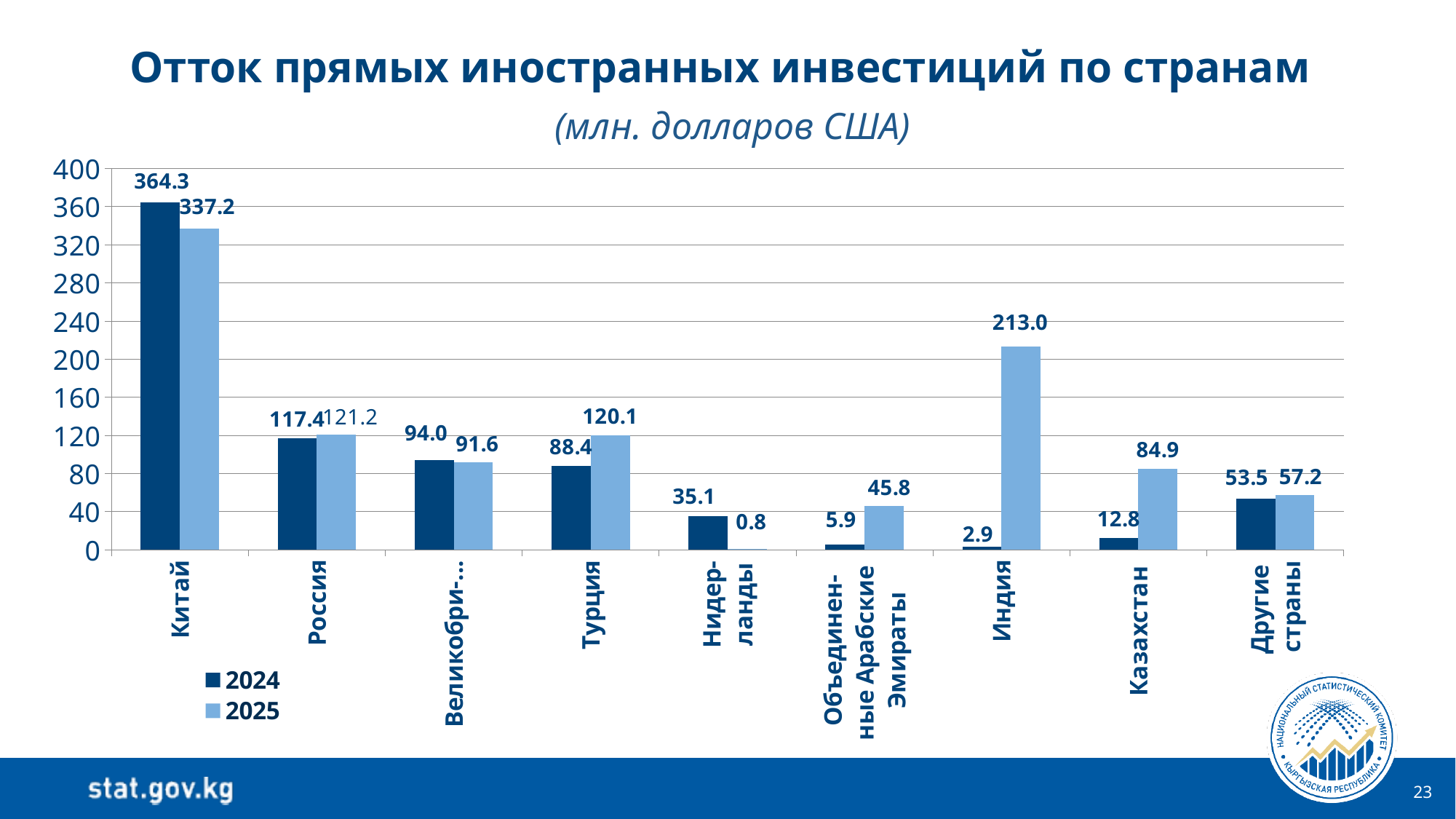
Which country has the lowest value in 2024? Индия How many series does the legend list? 2 What is the difference between the 2024 and 2025 values for Турция? 31.7 What is the value for Китай in 2024? 364.3 Is the 2025 value for Казахстан greater or less than 80? greater What is the value for Индия in 2025? 213.0 Which is larger for Россия: the 2024 value or the 2025 value? 2025 How many categories are shown on the x axis? 9 What is the value for Казахстан in 2024? 12.8 Which country has the highest value in 2025? Китай What is the value for Нидерланды in 2025? 0.8 What kind of chart is shown on the slide? Bar chart